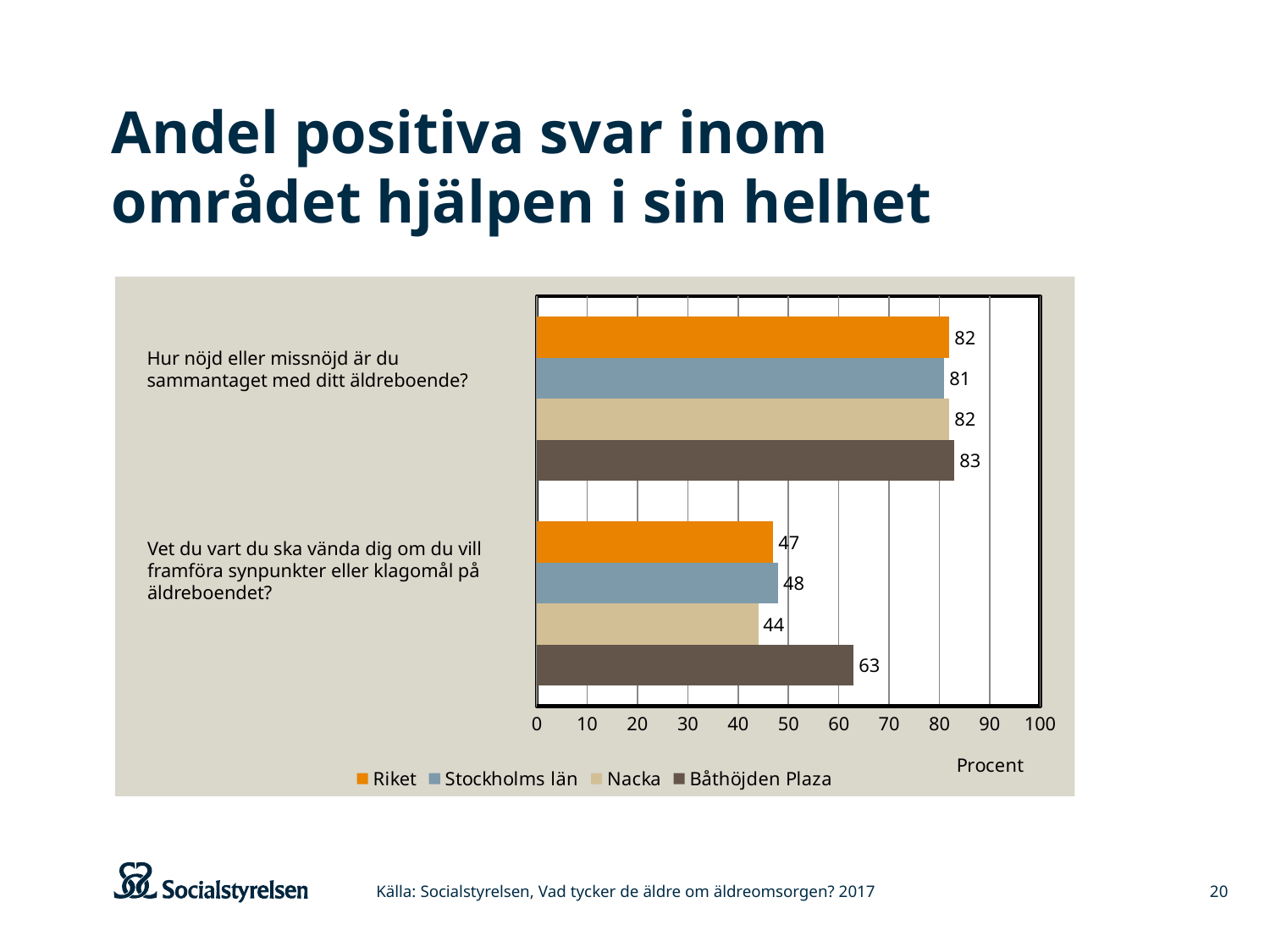
What is the difference between the Båthöjden Plaza value and the Nacka value for the question 'Vet du vart du ska vända dig om du vill framföra synpunkter eller klagomål på äldreboendet?' 19 What unit is shown on the horizontal axis of the chart? Procent What value does Stockholms län have for the question 'Hur nöjd eller missnöjd är du sammantaget med ditt äldreboende?' 81 Which is larger for Båthöjden Plaza: the value for 'Hur nöjd eller missnöjd är du sammantaget med ditt äldreboende?' or the value for 'Vet du vart du ska vända dig om du vill framföra synpunkter eller klagomål på äldreboendet?' Hur nöjd eller missnöjd är du sammantaget med ditt äldreboende? How many series does the legend list? 4 What value does Båthöjden Plaza have for the question 'Vet du vart du ska vända dig om du vill framföra synpunkter eller klagomål på äldreboendet?' 63 What is the difference between the Riket values for the two questions? 35 What value does Nacka have for the question 'Vet du vart du ska vända dig om du vill framföra synpunkter eller klagomål på äldreboendet?' 44 What kind of chart is shown on the slide? Bar chart Which series has the highest value for the question 'Vet du vart du ska vända dig om du vill framföra synpunkter eller klagomål på äldreboendet?' Båthöjden Plaza Which series has the lowest value for the question 'Vet du vart du ska vända dig om du vill framföra synpunkter eller klagomål på äldreboendet?' Nacka How many questions (categories) are shown on the chart? 2